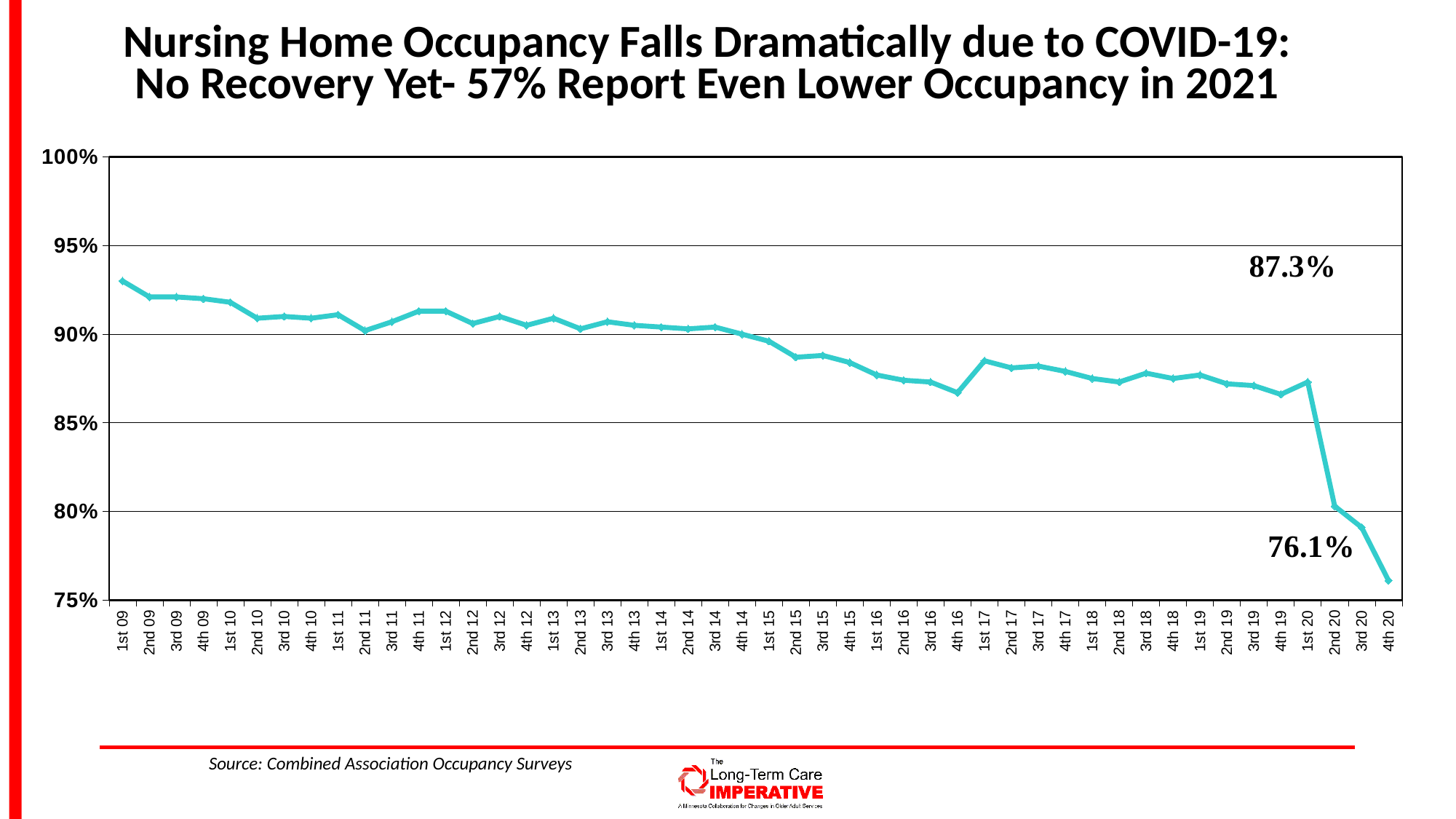
Which quarter has the highest occupancy on the chart? 1st 09 Is the value for 4th 16 greater or less than 90%? less What source is cited for the chart data? Combined Association Occupancy Surveys Is the value for 2nd 20 greater or less than 85%? less Which is larger, the occupancy in 1st 09 or in 4th 20? 1st 09 Which quarter has the lowest occupancy on the chart? 4th 20 What is the nursing home occupancy value labelled for 4th 20? 76.1% What is the difference between the two labelled values, 87.3% and 76.1%? 11.2 percentage points What is the higher of the two values labelled on the chart? 87.3% Overall, do occupancy values rise or fall from 1st 09 to 4th 20? fall Is the value for 1st 09 greater or less than 90%? greater What kind of chart is shown on the slide? line chart